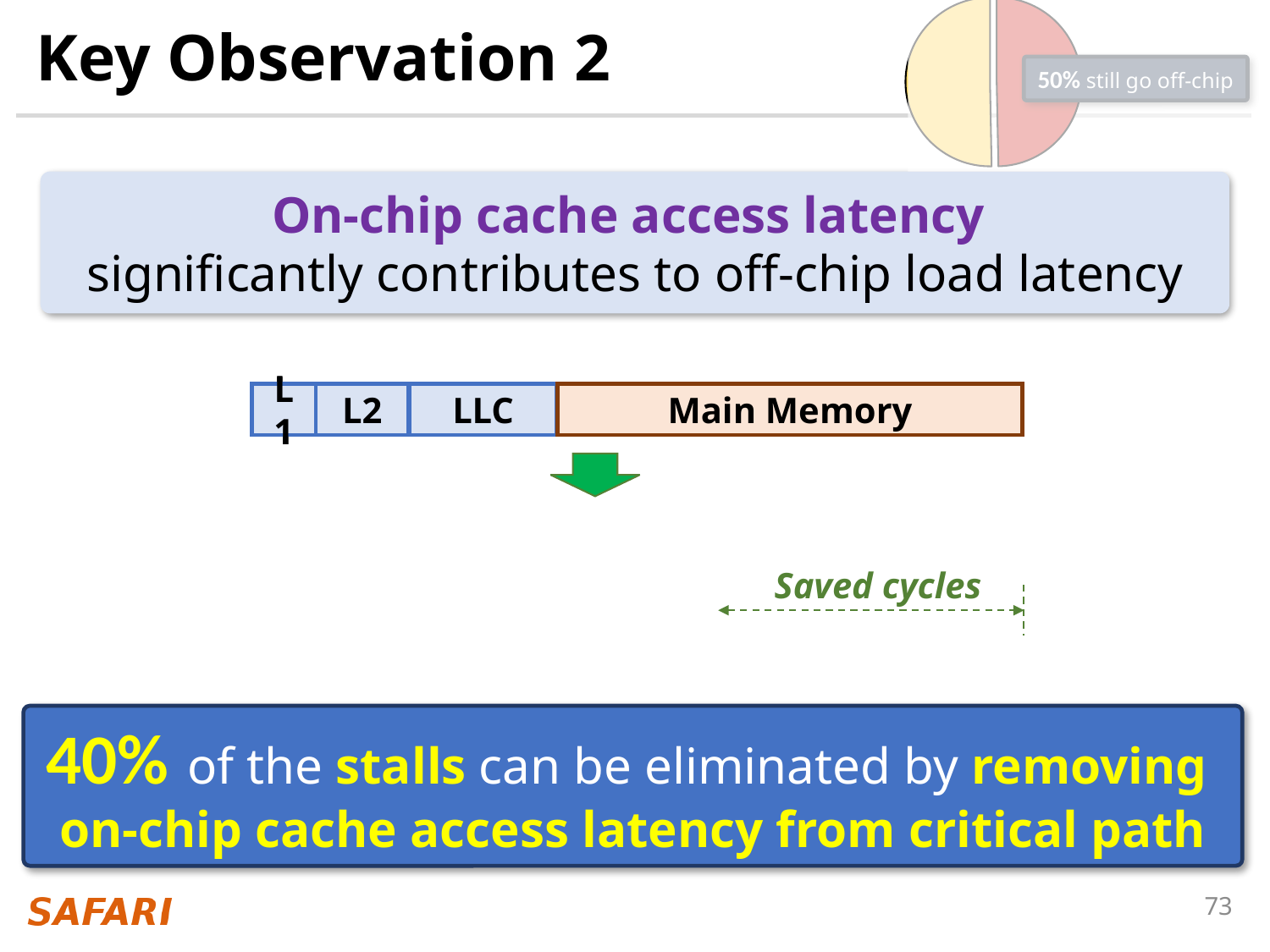
What colour is the slice of the pie chart labelled "50% still go off-chip"? Red In the pie chart, what share of the pie is labelled as still going off-chip? 50% What kind of chart is shown in the top-right corner of the slide? Pie chart How many slices does the pie chart in the top-right corner have? 2 What is the text of the label attached to the red slice of the pie chart? 50% still go off-chip